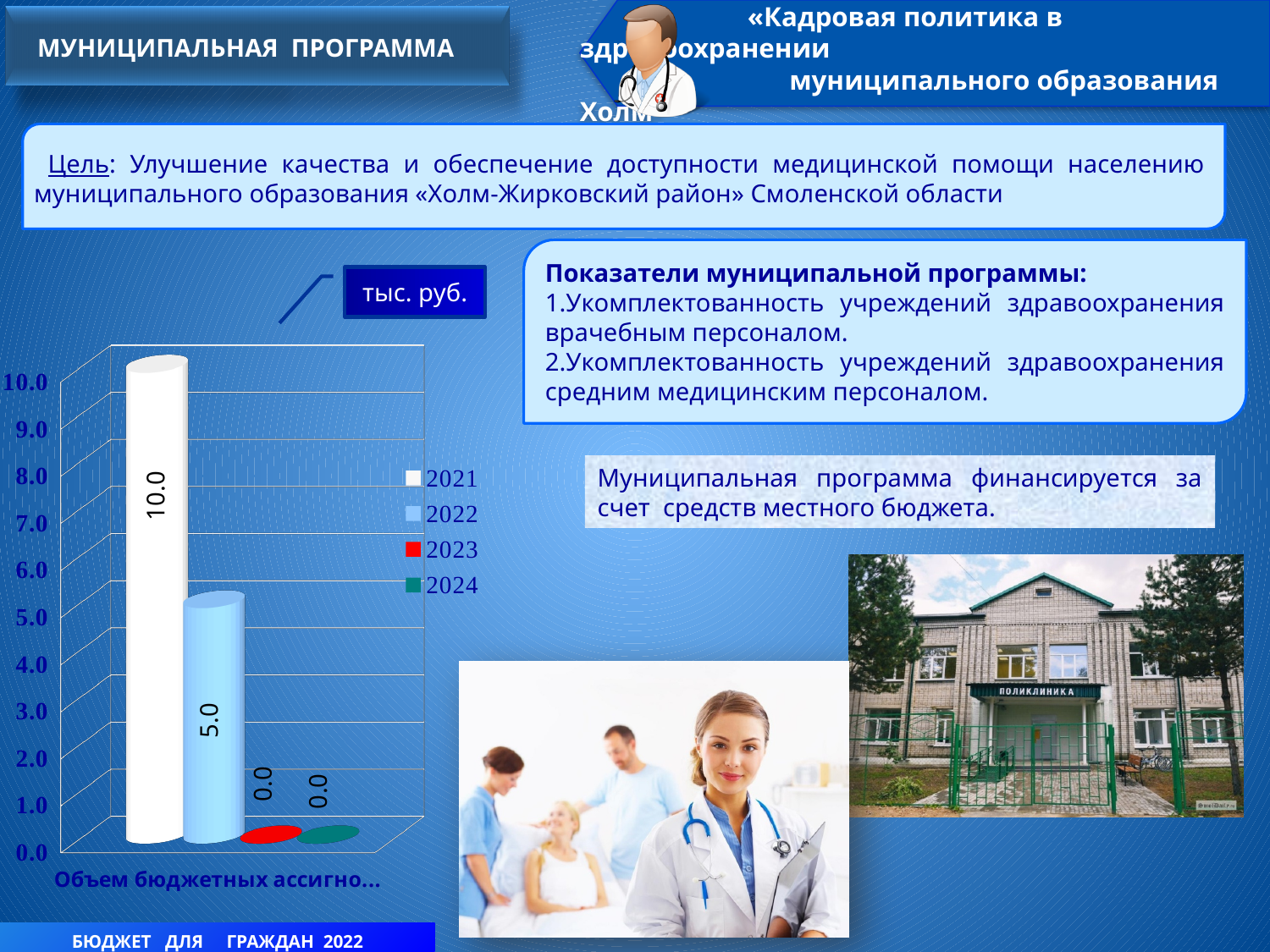
What unit is shown in the box above the chart? тыс. руб. What is the value for 2022 on the chart? 5.0 What is the value for 2023 on the chart? 0.0 Which is larger, the value for 2021 or the value for 2022? 2021 What is the value for 2024 on the chart? 0.0 Do the values rise or fall from 2021 to 2024? fall What is the difference between the values for 2021 and 2022? 5.0 Is the value for 2022 greater or less than 8.0? less How many series does the legend list? 4 What kind of chart is shown on the slide? bar chart Which year has the highest value on the chart? 2021 What is the value for 2021 on the chart? 10.0